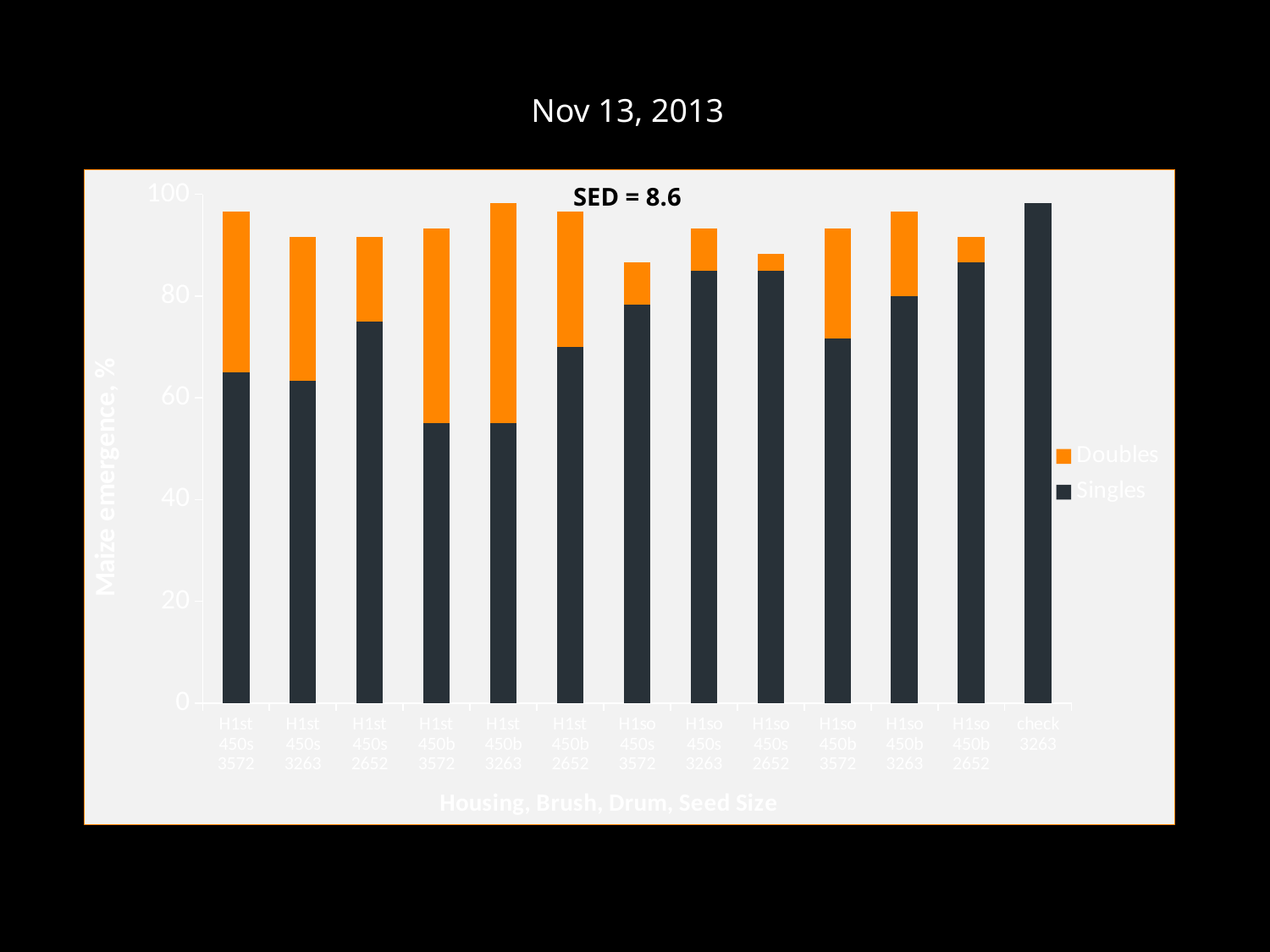
Which has the larger Singles value, H1so 450s 3263 or H1st 450s 3572? H1so 450s 3263 Is the Singles value for H1so 450s 3263 greater or less than 80? greater What kind of chart is shown on the slide? stacked bar chart Is the Singles value for H1st 450s 2652 greater or less than 80? less What is the label of the y axis? Maize emergence, % What is the SED value printed on the chart? SED = 8.6 Which category has the highest Singles value? check 3263 Is the Singles value for H1st 450b 3572 greater or less than 60? less How many categories are shown along the x axis? 13 Which category has no Doubles segment? check 3263 How many series does the legend list? 2